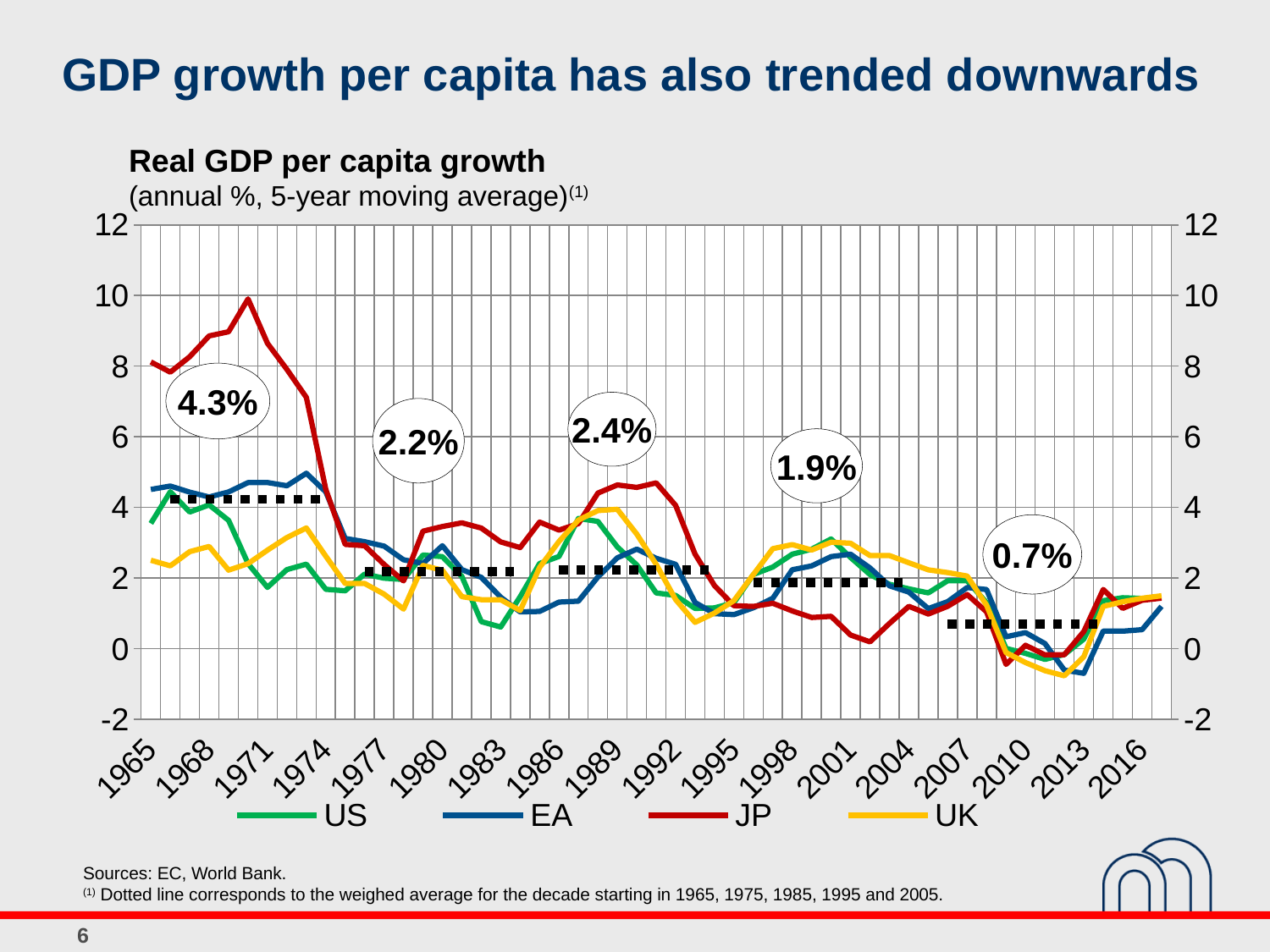
What is the weighted average growth shown for the decade starting in 1965? 4.3% What is the title of the chart? Real GDP per capita growth What kind of chart is shown on the slide? line chart How many series does the legend list? 4 Which is larger, the decade average starting in 1975 or the one starting in 1985? 1985 (2.4%) What is the weighted average growth shown for the decade starting in 1985? 2.4% Which series are listed in the legend? US, EA, JP, UK What is the weighted average growth shown for the decade starting in 2005? 0.7% What is the difference between the decade averages for 1965 (4.3%) and 2005 (0.7%)? 3.6 percentage points Is the value for JP around 1971 greater or less than 8? greater Which decade has the highest weighted average growth shown on the chart? the decade starting in 1965 (4.3%) Which decade has the lowest weighted average growth shown on the chart? the decade starting in 2005 (0.7%)